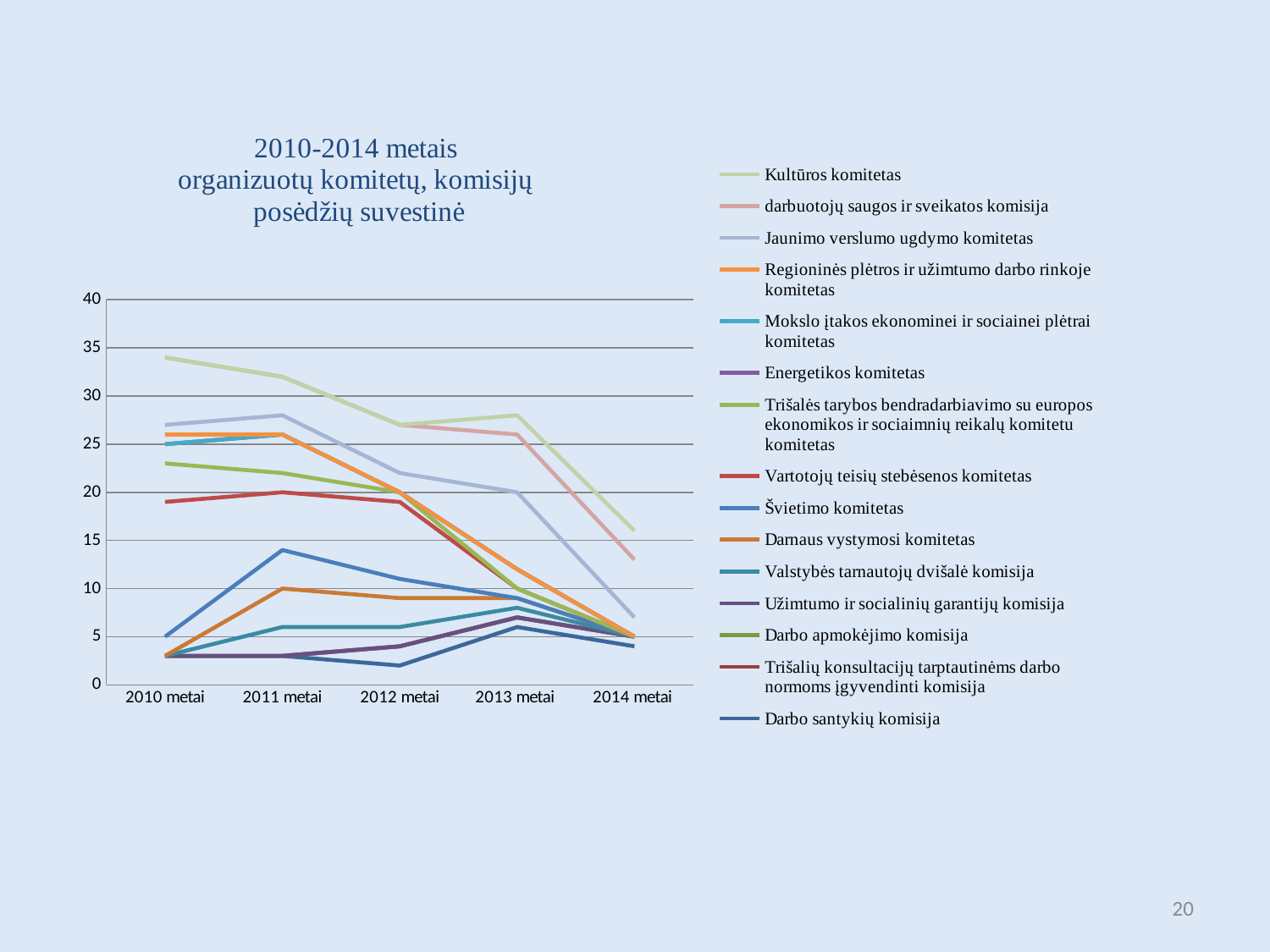
What kind of chart is shown on the slide? line chart Which series is listed first in the chart's legend? Kultūros komitetas Is the value for Kultūros komitetas in 2014 metai greater or less than 20? less What is the title of the chart? 2010-2014 metais organizuotų komitetų, komisijų posėdžių suvestinė Is the value for Darbo santykių komisija in 2012 metai greater or less than 5? less How many series does the chart's legend list? 15 Is the value for Jaunimo verslumo ugdymo komitetas in 2014 metai greater or less than 10? less How many years are shown on the x axis of the chart? 5